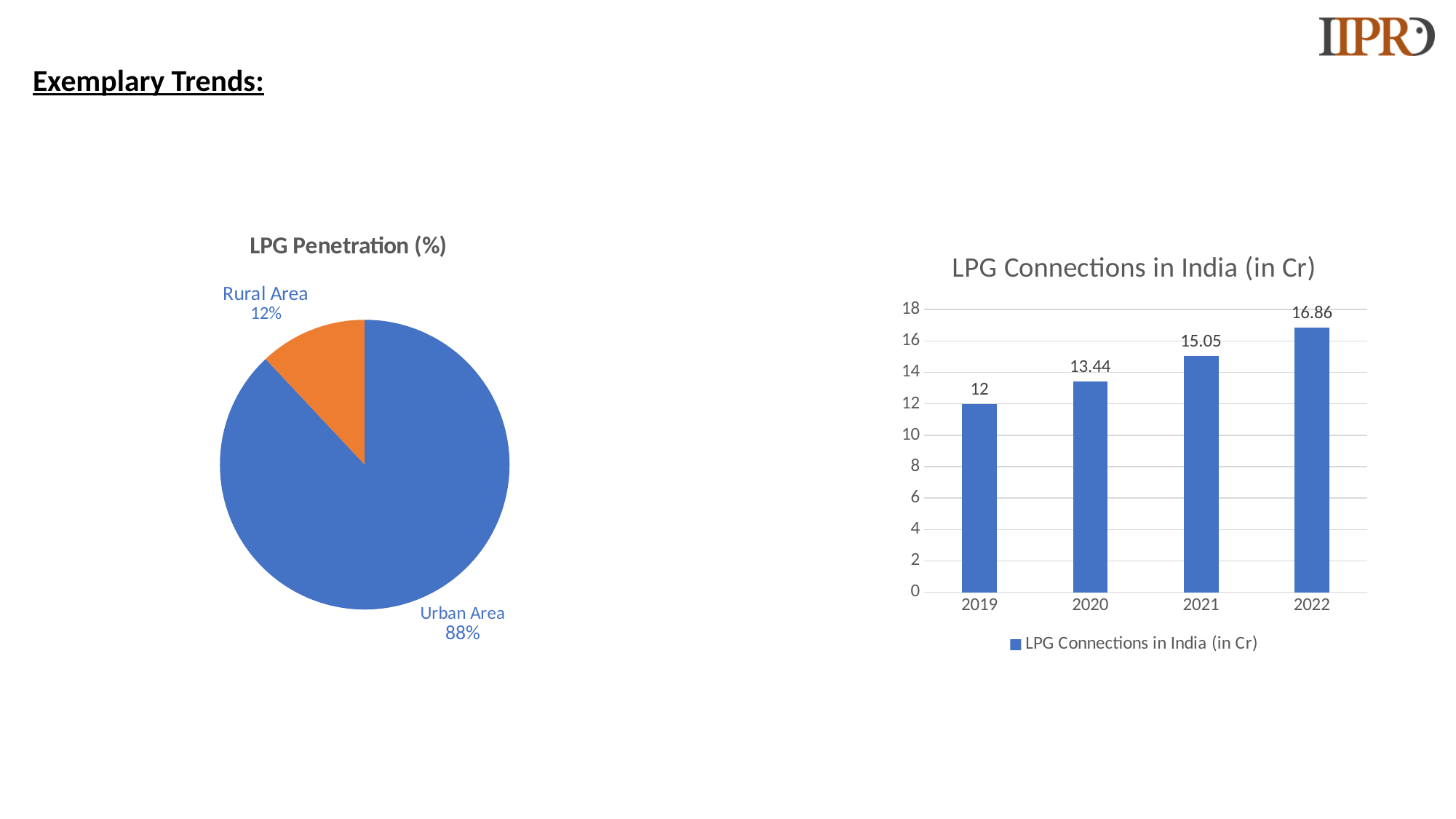
What kind of chart is 'LPG Connections in India (in Cr)'? Bar chart In the 'LPG Penetration (%)' chart, which area has the larger slice? Urban Area In the 'LPG Penetration (%)' chart, what share does Rural Area have? 12% What kind of chart is 'LPG Penetration (%)'? Pie chart In the 'LPG Connections in India (in Cr)' chart, which year has the lowest value? 2019 In the 'LPG Connections in India (in Cr)' chart, what is the difference between the 2022 and 2019 values? 4.86 In the 'LPG Penetration (%)' chart, what share does Urban Area have? 88% How many years are shown on the x axis of the 'LPG Connections in India (in Cr)' chart? 4 How many slices does the 'LPG Penetration (%)' pie chart have? 2 In the 'LPG Connections in India (in Cr)' chart, what is the value for 2020? 13.44 In the 'LPG Connections in India (in Cr)' chart, do the values rise or fall from 2019 to 2022? Rise In the 'LPG Connections in India (in Cr)' chart, what is the value for 2022? 16.86